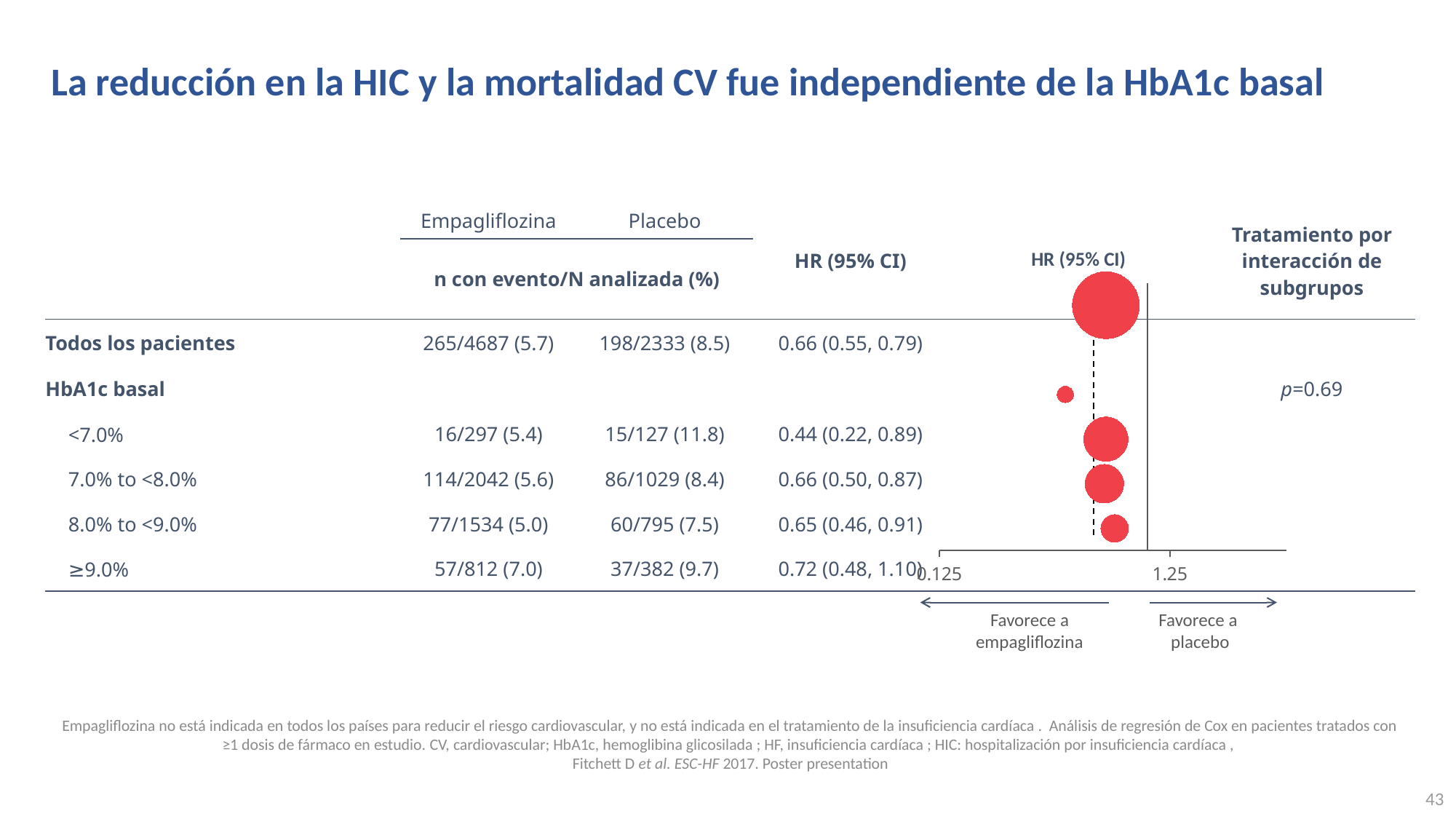
What is the HR (95% CI) for the HbA1c basal <7.0% subgroup? 0.44 (0.22, 0.89) What is the HR (95% CI) for the 8.0% to <9.0% subgroup? 0.65 (0.46, 0.91) How many bubbles (hazard ratio points) are plotted in the chart? 5 What is the HR (95% CI) for the HbA1c basal ≥9.0% subgroup? 0.72 (0.48, 1.10) What is the p-value for treatment by subgroup interaction shown on the slide? p=0.69 Which HbA1c basal subgroup has the highest hazard ratio? ≥9.0% What is the difference between the hazard ratio of the ≥9.0% subgroup and the <7.0% subgroup? 0.28 What kind of chart is shown on the right of the slide? bubble chart (forest plot) Which HbA1c basal subgroup has the lowest hazard ratio? <7.0% Which has the larger hazard ratio: the <7.0% subgroup or the ≥9.0% subgroup? ≥9.0% What does the left-pointing arrow below the chart's x axis indicate? Favorece a empagliflozina What is the HR (95% CI) for all patients (Todos los pacientes)? 0.66 (0.55, 0.79)